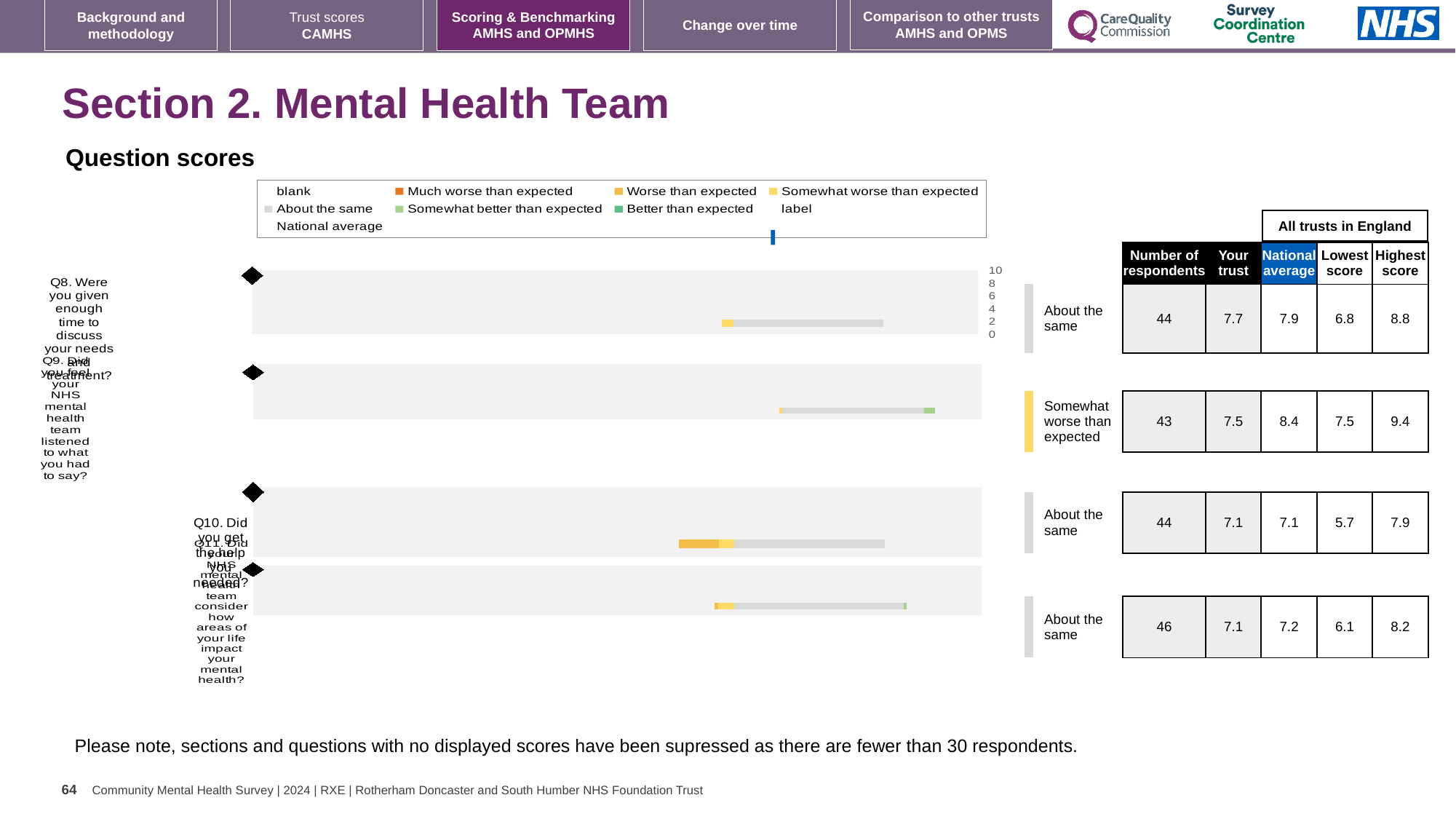
What benchmark category is shown next to Q9 in the question scores chart? Somewhat worse than expected For Q8, which is larger: the 'Your trust' score or the national average? National average How many respondents answered Q11 (Did your NHS mental health team consider how areas of your life impact your mental health?)? 46 Which question has the highest 'Your trust' score? Q8 What is the national average score for Q9 (Did you feel your NHS mental health team listened to what you had to say?)? 8.4 Which question has the lowest 'Lowest score' among all trusts in England? Q10 What is the lowest score among all trusts in England for Q10 (Did you get the help you needed?)? 5.7 What is the highest score among all trusts in England for Q9? 9.4 How many questions (Q8 to Q11) are plotted in the question scores chart? 4 For Q9, what is the difference between the national average and the 'Your trust' score? 0.9 What is the 'Your trust' score for Q8 (Were you given enough time to discuss your needs and treatment?)? 7.7 What kind of chart is used to show the question scores on this slide? bar chart